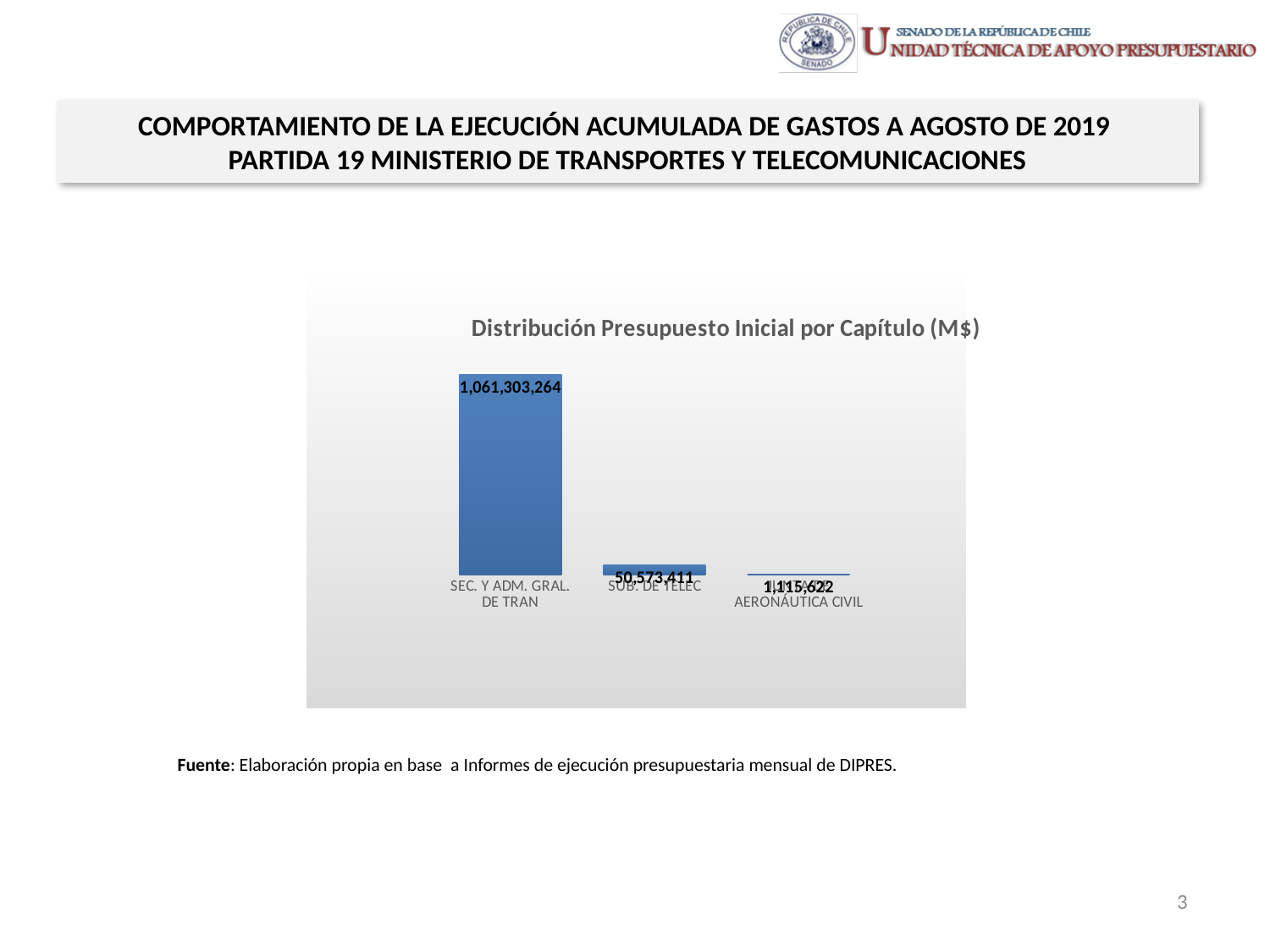
Which category has the highest value? SEC. Y ADM. GRAL. DE TRAN Do the values rise or fall from left to right across the categories? Fall Which is larger, the value for SUB. DE TELEC or the value for AERONÁUTICA CIVIL? SUB. DE TELEC What is the value for SEC. Y ADM. GRAL. DE TRAN? 1,061,303,264 What is the title of the chart? Distribución Presupuesto Inicial por Capítulo (M$) Which category has the lowest value? AERONÁUTICA CIVIL What is the value for SUB. DE TELEC? 50,573,411 What is the difference between the values for SEC. Y ADM. GRAL. DE TRAN and SUB. DE TELEC? 1,010,729,853 What type of chart is shown on the slide? Bar chart What is the difference between the values for SUB. DE TELEC and AERONÁUTICA CIVIL? 49,457,789 What is the value for AERONÁUTICA CIVIL? 1,115,622 How many categories (capítulos) are plotted in the chart? 3